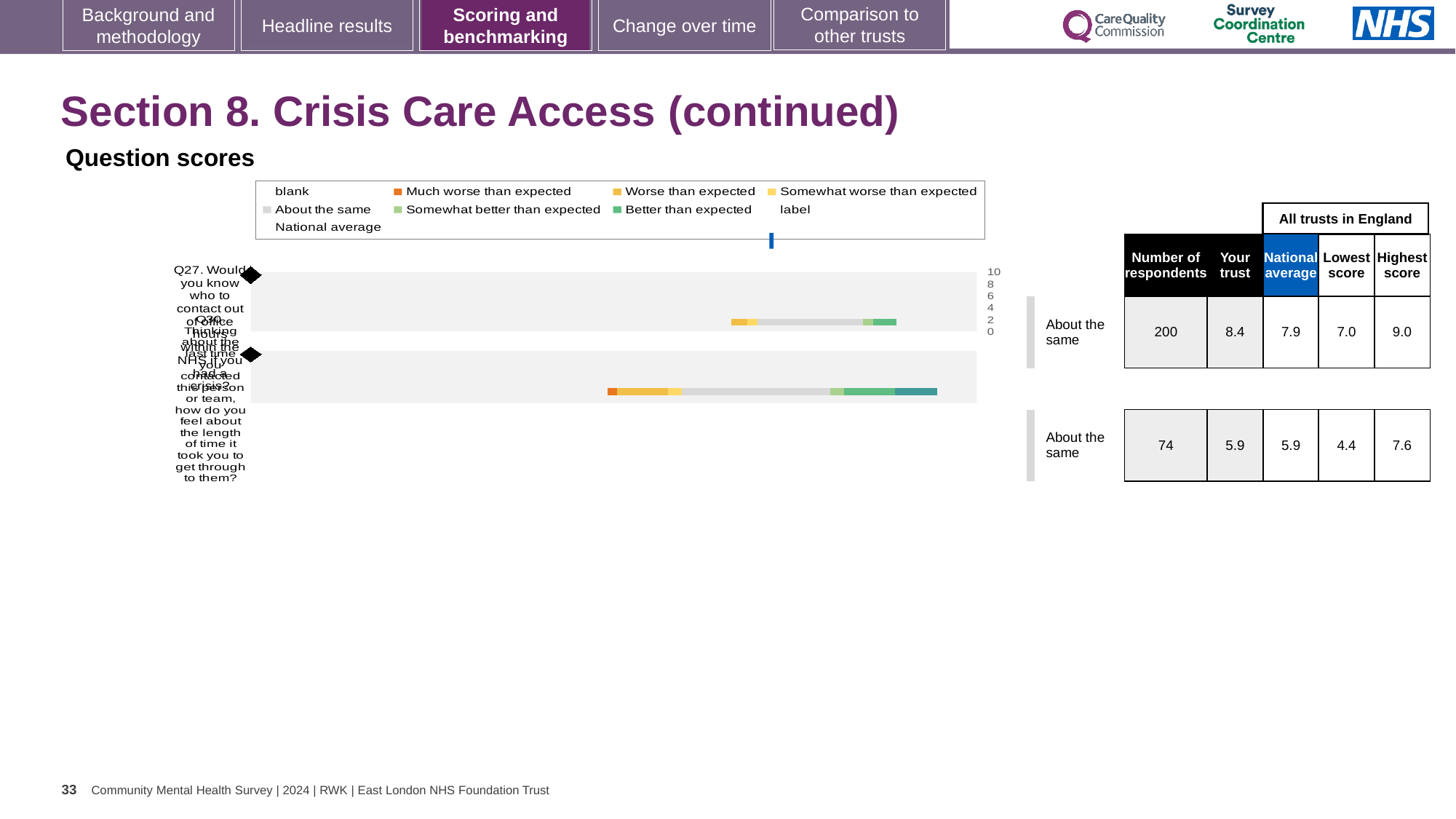
In the table beside the chart, what is the lowest score for Q28? 4.4 In the table beside the chart, what is the 'Your trust' score for Q27? 8.4 How many survey questions are plotted in the chart? 2 Which question has more respondents, Q27 or Q28? Q27 Which colour does the legend use for 'Much worse than expected'? orange For Q27, which is larger: the 'Your trust' score or the national average? Your trust In the table beside the chart, what is the 'Your trust' score for Q28? 5.9 What kind of chart is shown under 'Question scores'? bar chart What is the difference between the highest score and the lowest score for Q27? 2.0 In the table beside the chart, how many respondents answered Q27? 200 What is the heading above the chart? Question scores In the table beside the chart, what is the national average for Q27? 7.9